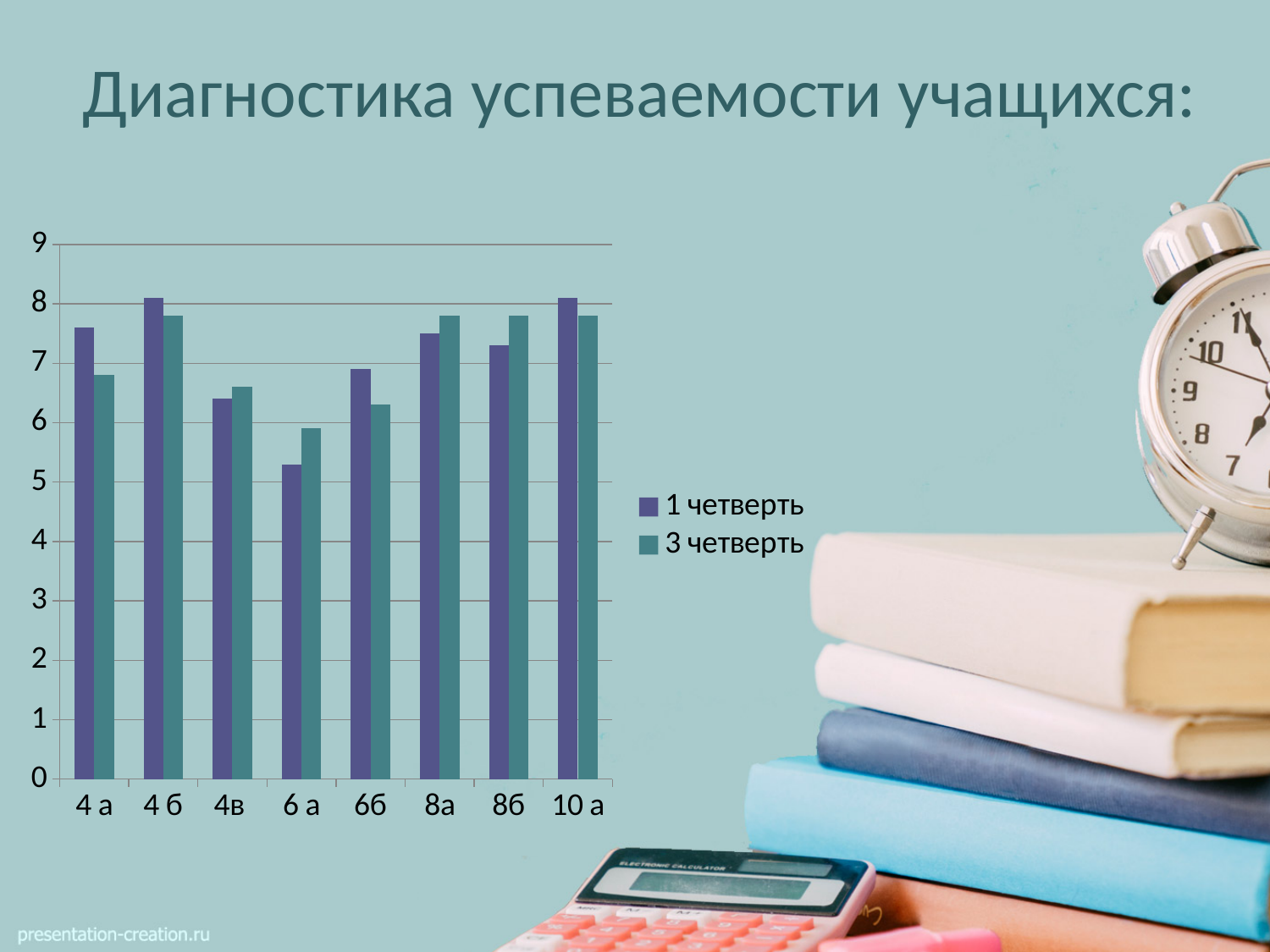
Which class has the lowest value for 1 четверть? 6 а For class 6 а, which is larger: the 1 четверть value or the 3 четверть value? 3 четверть Is the 1 четверть value for 6 а greater or less than 6? less For class 4 а, which is larger: the 1 четверть value or the 3 четверть value? 1 четверть Which class has the lowest value for 3 четверть? 6 а What kind of chart is shown on the slide? bar chart Is the 3 четверть value for 8а greater or less than 7? greater How many categories (classes) are shown on the x axis of the chart? 8 How many series does the chart legend list? 2 What is the title of the slide containing the chart? Диагностика успеваемости учащихся: Is the 3 четверть value for 4 а greater or less than 7? less